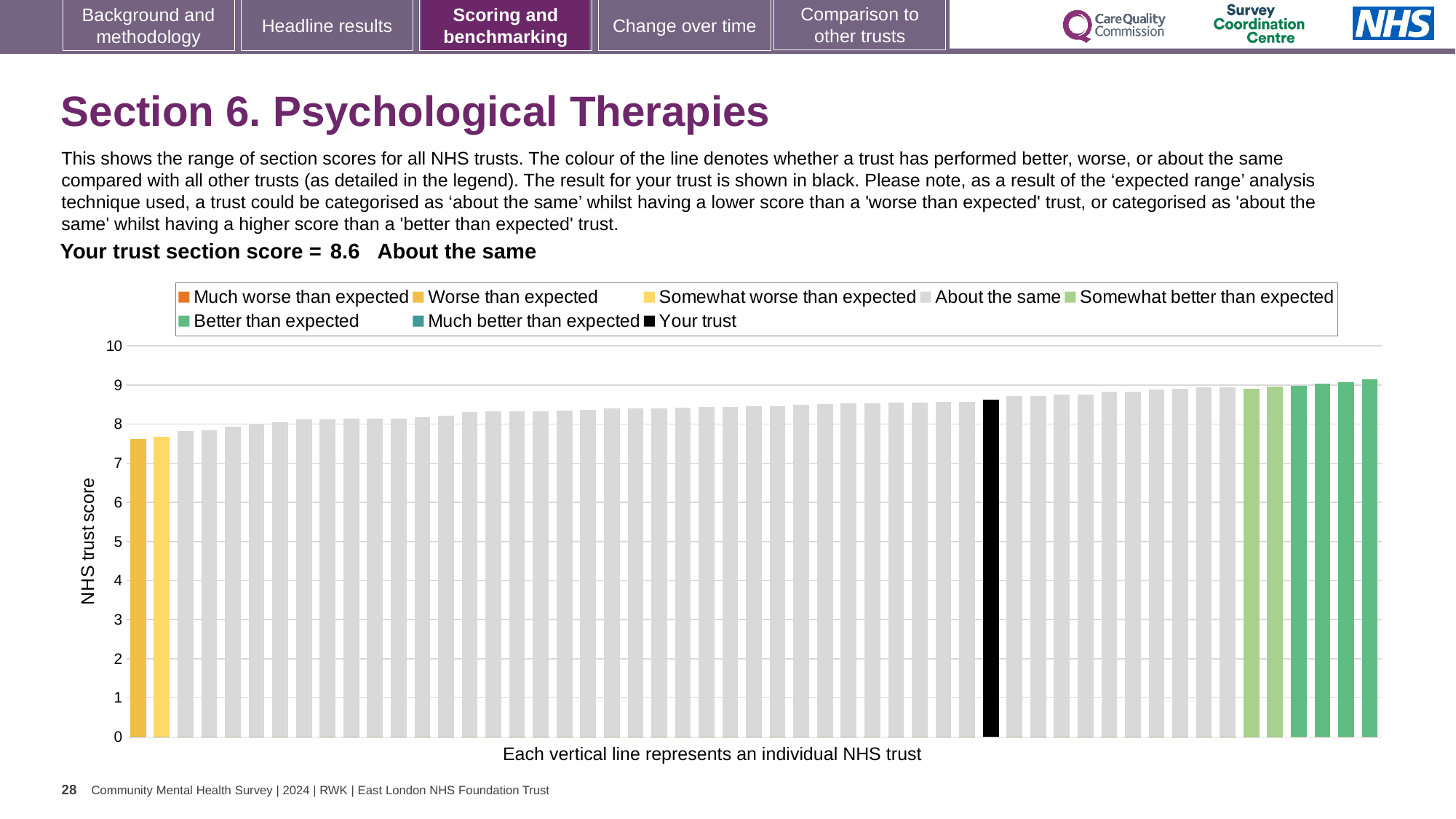
What is the label on the vertical axis of the chart? NHS trust score What is the section score for your trust shown on the slide? 8.6 Is the value of the black 'Your trust' bar greater or less than 8? greater What colour is used for the 'Your trust' bar in the chart? black Which performance category is your trust placed in for Section 6? About the same Which legend category do the highest-scoring trusts (rightmost bars) belong to? Better than expected Is the value of the leftmost (lowest) bar greater or less than 8? less Do the bar values rise or fall from left to right along the x axis? rise Which legend category does the lowest-scoring trust (leftmost bar) belong to? Worse than expected Is the value of the black 'Your trust' bar greater or less than 9? less What kind of chart is shown on the slide? bar chart How many entries does the chart legend list? 8